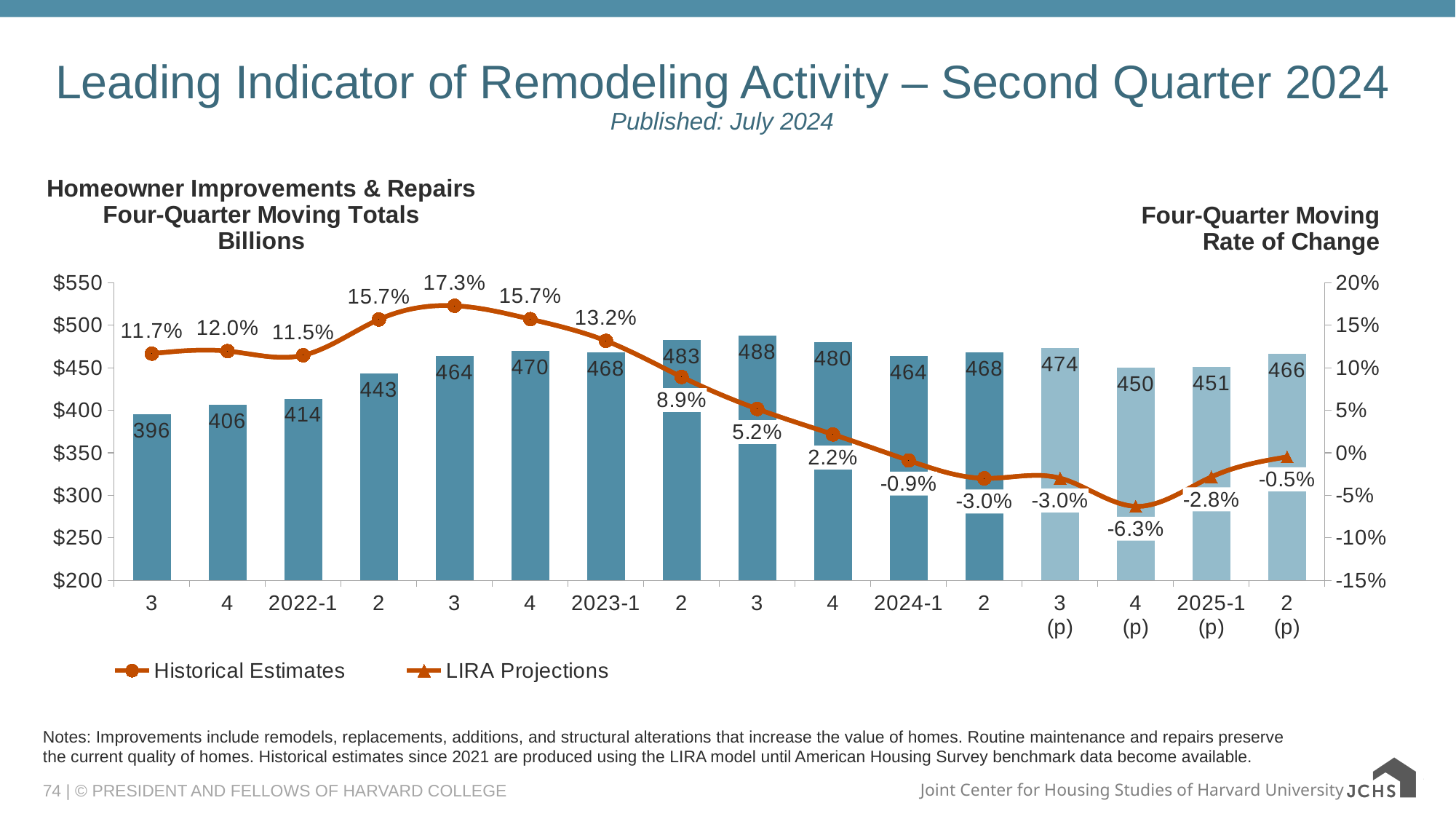
Which is larger, the four-quarter moving total for 2023-1 or for 2025-1 (p)? 2023-1 What is the four-quarter moving rate of change for 2023-1? 13.2% What is the difference between the four-quarter moving totals for 2024-1 and 2022-1? 50 What is the four-quarter moving total for 2025-1 (p)? 451 Which quarter has the highest four-quarter moving total bar? 2023-3 (the bar labeled 3 after 2023-1), 488 How many bars (quarters) are plotted on the chart? 16 What is the highest four-quarter moving rate of change on the line? 17.3% Which quarter has the lowest four-quarter moving total bar? The first bar, labeled 3 (2021-3), 396 What are the two legend entries on the chart? Historical Estimates and LIRA Projections What is the four-quarter moving total (in billions) for 2024-1? 464 How many series does the legend list? 2 What is the rate of change shown for the 4 (p) quarter following 2024-1? -6.3%